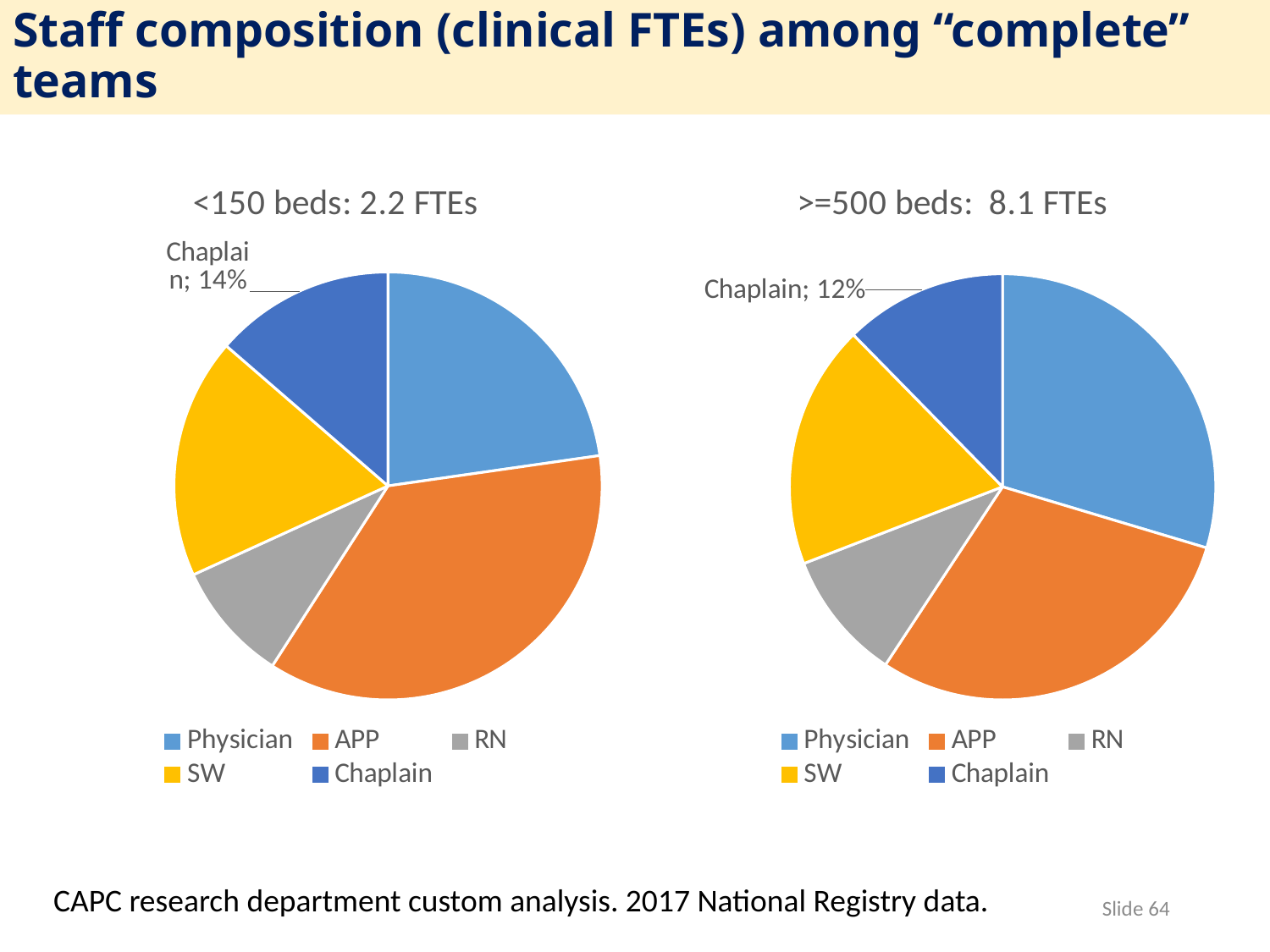
What type of chart is used on the left of the slide? Pie chart In the ">=500 beds: 8.1 FTEs" pie chart, which slice is larger, Physician or SW? Physician In the "<150 beds: 2.2 FTEs" pie chart, which category has the largest slice? APP In the "<150 beds: 2.2 FTEs" pie chart, which colour represents SW? Yellow In the "<150 beds: 2.2 FTEs" pie chart, what percentage is labelled for Chaplain? 14% In the ">=500 beds: 8.1 FTEs" pie chart, what percentage is labelled for Chaplain? 12% How many slices does the "<150 beds: 2.2 FTEs" pie chart have? 5 In the "<150 beds: 2.2 FTEs" pie chart, which category has the smallest slice? RN In the "<150 beds: 2.2 FTEs" pie chart, which slice is larger, APP or Physician? APP How many entries does the legend of the ">=500 beds: 8.1 FTEs" chart list? 5 What is the title of the chart on the right of the slide? >=500 beds: 8.1 FTEs